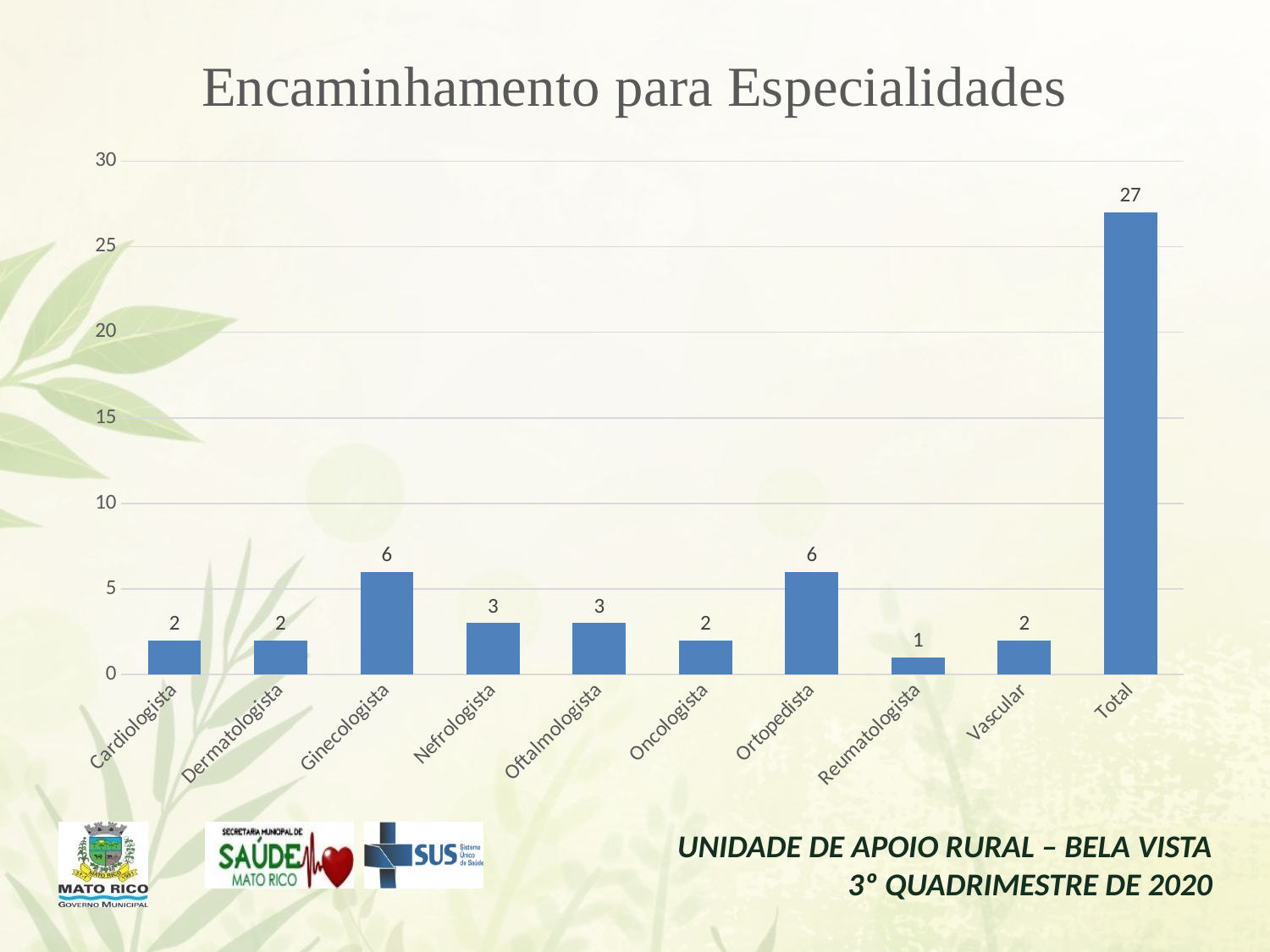
What is the value for Nefrologista? 3 Which category has the lowest value? Reumatologista What is the value for Reumatologista? 1 Is the value for Total greater or less than 25? greater What kind of chart is shown on the slide? bar chart What is the title of the chart? Encaminhamento para Especialidades What is the value shown for Total? 27 How many categories are shown on the x axis, including Total? 10 Excluding Total, which categories have the highest value? Ginecologista and Ortopedista What is the value for Ginecologista? 6 Which is larger, the value for Oftalmologista or the value for Vascular? Oftalmologista What is the difference between the values for Ortopedista and Oncologista? 4